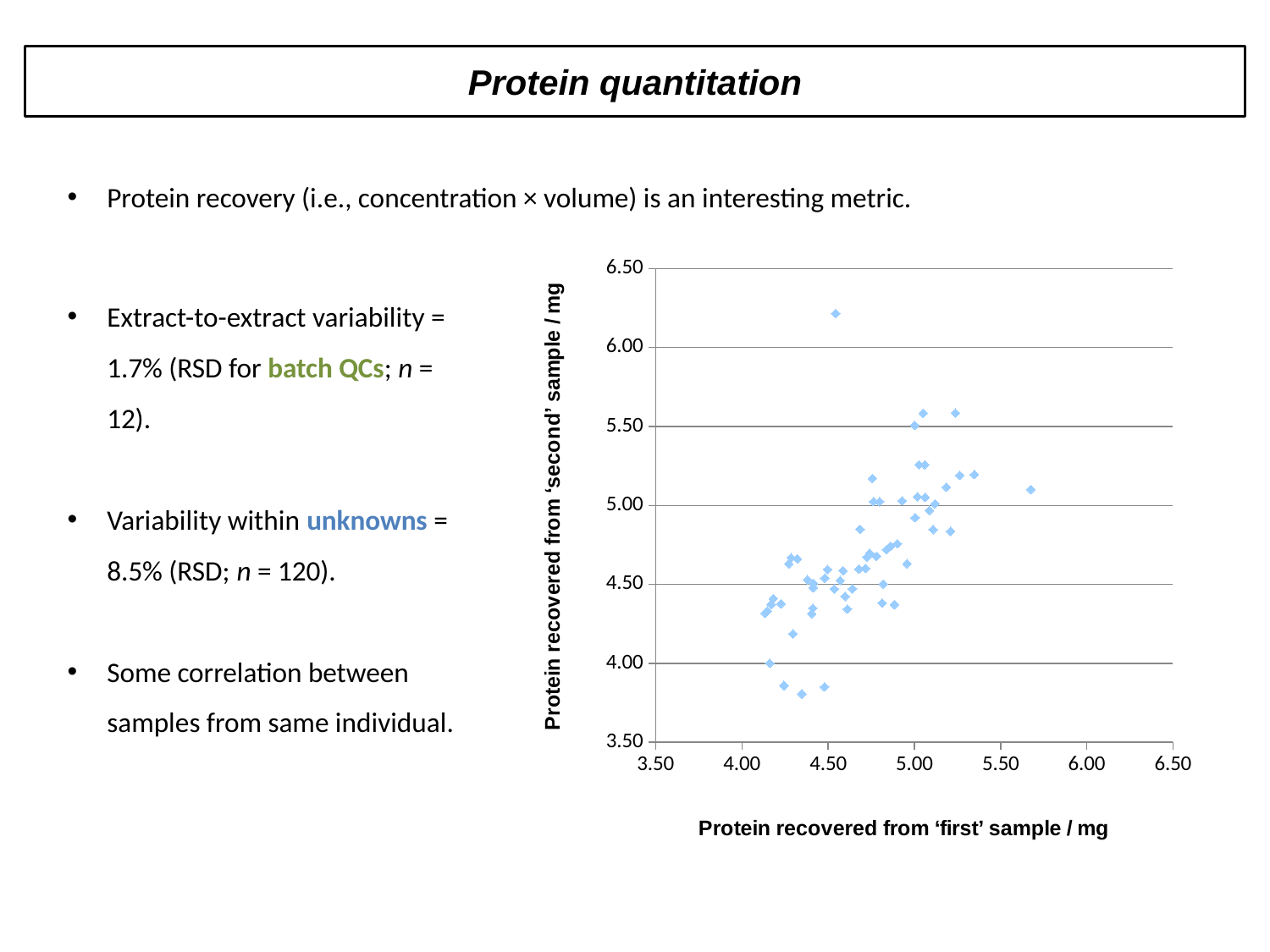
Is the x value of the rightmost point on the chart greater or less than 5.50? greater What kind of chart is shown on the slide? scatter chart As the protein recovered from the 'first' sample increases, does the protein recovered from the 'second' sample generally rise or fall? rise Is the x value of the leftmost point on the chart greater or less than 4.50? less Is the y value of the lowest point on the chart greater or less than 4.00? less What is the title of the x axis of the chart? Protein recovered from 'first' sample / mg What is the title of the y axis of the chart? Protein recovered from 'second' sample / mg